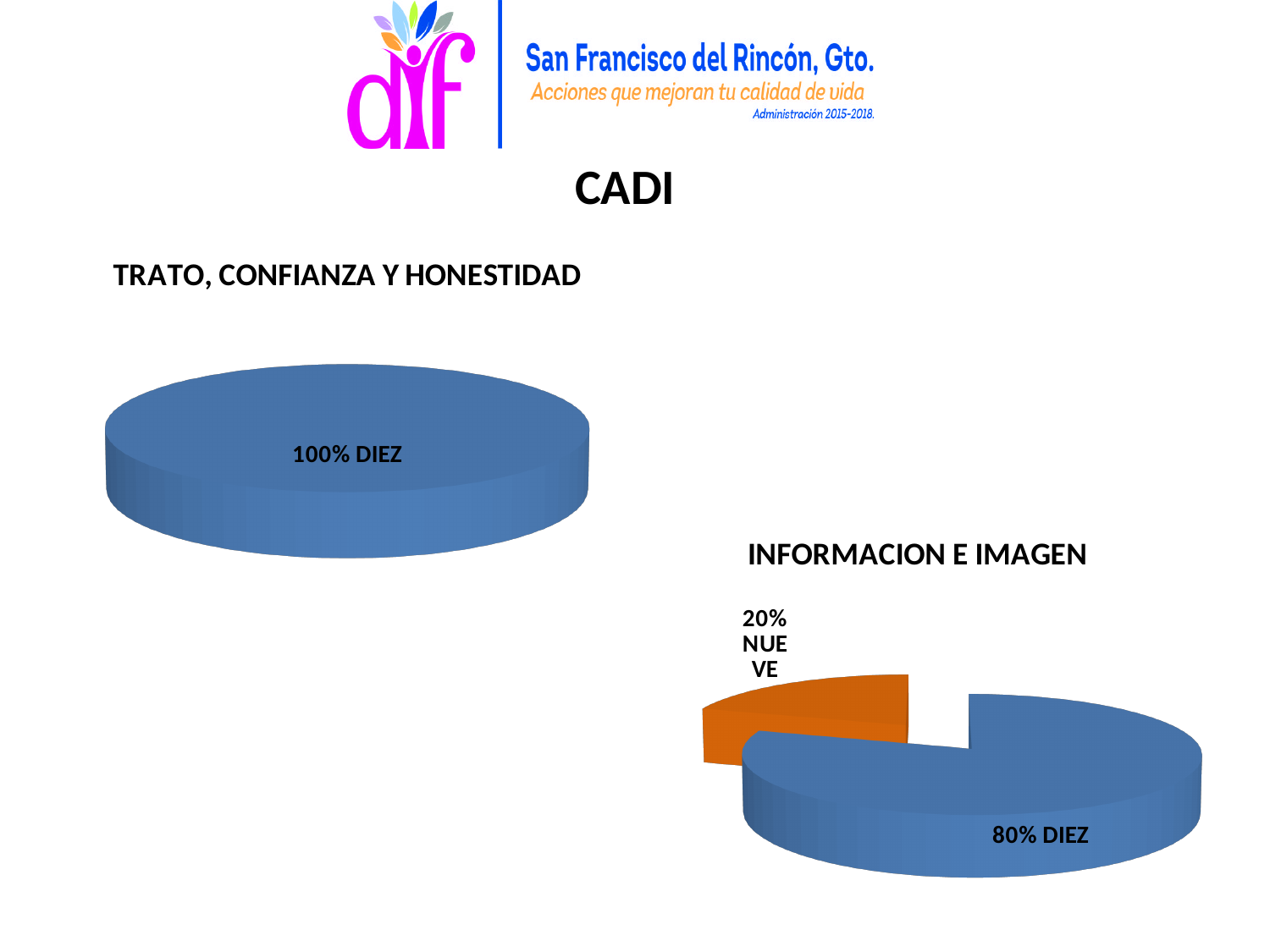
How many slices does the 'TRATO, CONFIANZA Y HONESTIDAD' chart have? 1 In the 'INFORMACION E IMAGEN' chart, what share of the pie is labelled NUEVE? 20% In the 'INFORMACION E IMAGEN' chart, what share of the pie is labelled DIEZ? 80% How many slices does the 'INFORMACION E IMAGEN' chart have? 2 In the 'INFORMACION E IMAGEN' chart, which slice is the smallest? NUEVE In the 'INFORMACION E IMAGEN' chart, which slice is the largest? DIEZ In the 'INFORMACION E IMAGEN' chart, what colour is the NUEVE slice? Orange In the 'INFORMACION E IMAGEN' chart, what is the difference in percentage points between the DIEZ and NUEVE slices? 60 In the 'TRATO, CONFIANZA Y HONESTIDAD' chart, what share of the pie is labelled DIEZ? 100% What kind of chart is the 'TRATO, CONFIANZA Y HONESTIDAD' chart? Pie chart In the 'INFORMACION E IMAGEN' chart, which slice is larger, DIEZ or NUEVE? DIEZ What is the title of the chart in the lower right of the slide? INFORMACION E IMAGEN